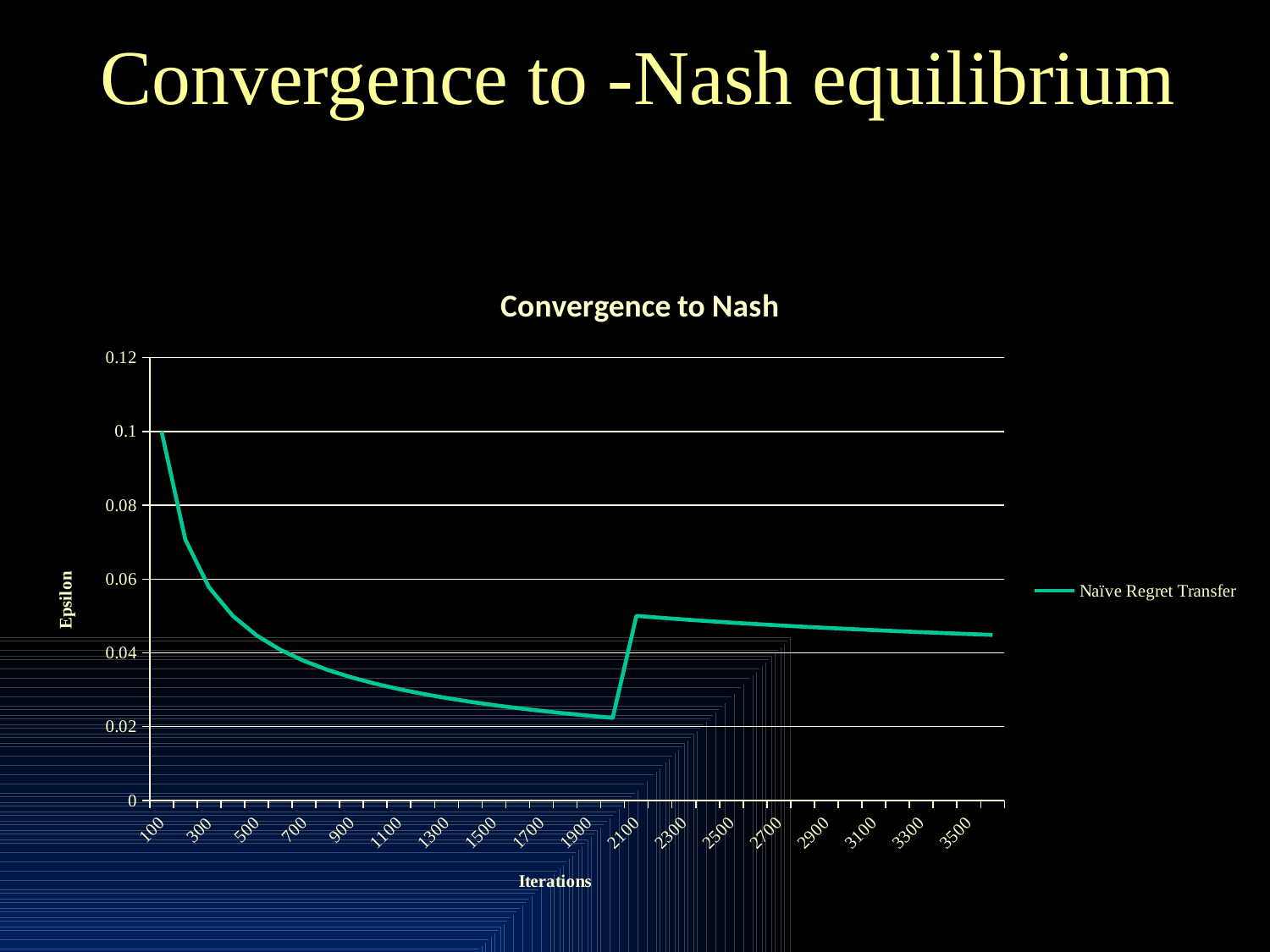
What is the title of the chart? Convergence to Nash How many series does the legend list? 1 What kind of chart is shown on the slide? line chart Is the value for Naïve Regret Transfer at 3500 iterations greater or less than 0.06? less Which is larger, the value at 100 iterations or the value at 3500 iterations? 100 iterations Does the value rise or fall along the x axis between 100 and 1900 iterations? fall Is the value for Naïve Regret Transfer at 1100 iterations greater or less than 0.04? less Is the value for Naïve Regret Transfer at 1900 iterations greater or less than 0.02? greater Which is larger, the value at 1900 iterations or the value at 2100 iterations? 2100 iterations What is the name of the series shown in the legend? Naïve Regret Transfer